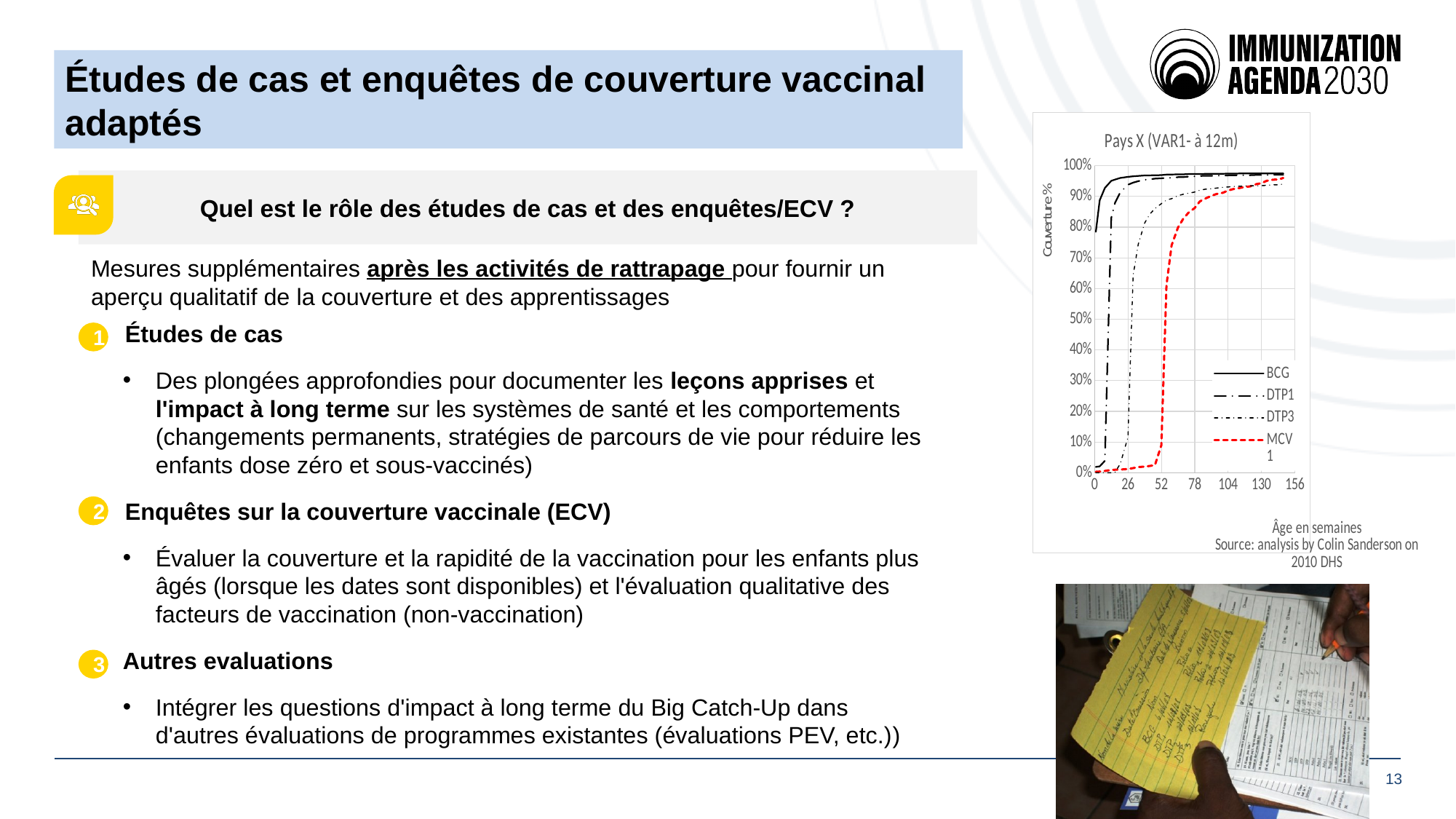
How many tick labels are shown on the x axis (age in weeks)? 7 How many series does the chart legend list? 4 Is the coverage for BCG at 26 weeks greater or less than 90%? greater Is the coverage for MCV1 at 78 weeks greater or less than 70%? greater What kind of chart is shown on the slide? line chart Which series has the lowest coverage at 52 weeks of age? MCV1 What is the title of the chart? Pays X (VAR1- à 12m) Which series is drawn with a red dashed line? MCV1 Is the coverage for MCV1 at 26 weeks greater or less than 10%? less At 26 weeks of age, which series has higher coverage, DTP1 or DTP3? DTP1 At 26 weeks of age, which series has higher coverage, BCG or MCV1? BCG Does coverage rise or fall as age in weeks increases along the x axis? rise